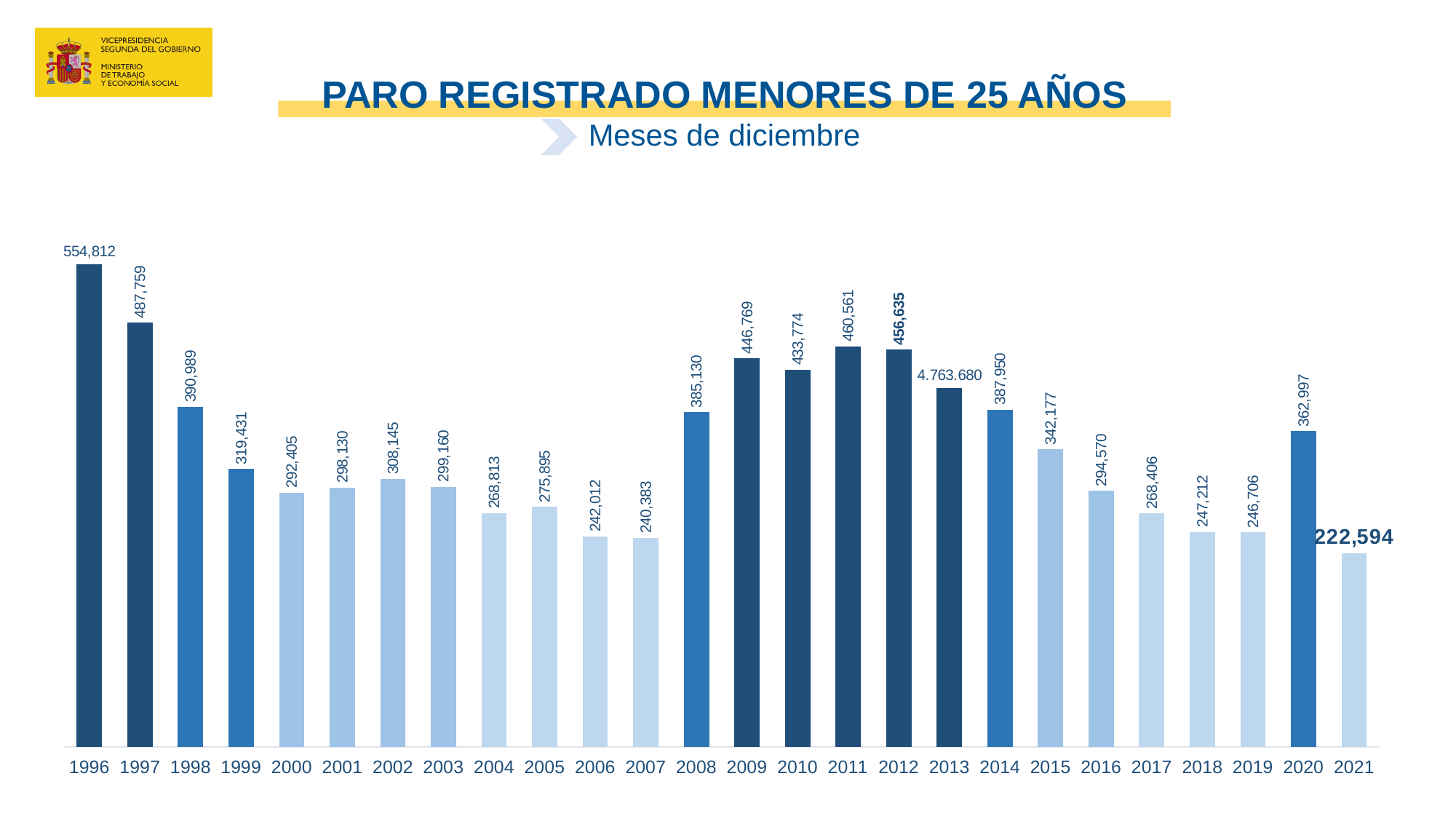
What is the value for 2016? 294,570 Which year has the lowest value? 2021 What is the difference between the values for 1996 and 1997? 67,053 What type of chart is shown on the slide? Bar chart How many years are shown on the x axis? 26 What is the title of the chart? PARO REGISTRADO MENORES DE 25 AÑOS What is the value for 2008? 385,130 Do the values rise or fall from 2014 to 2019? Fall Which is larger, the value for 2009 or the value for 2010? 2009 Which year has the highest value? 1996 What is the difference between the values for 2020 and 2021? 140,403 What is the value for 2021? 222,594